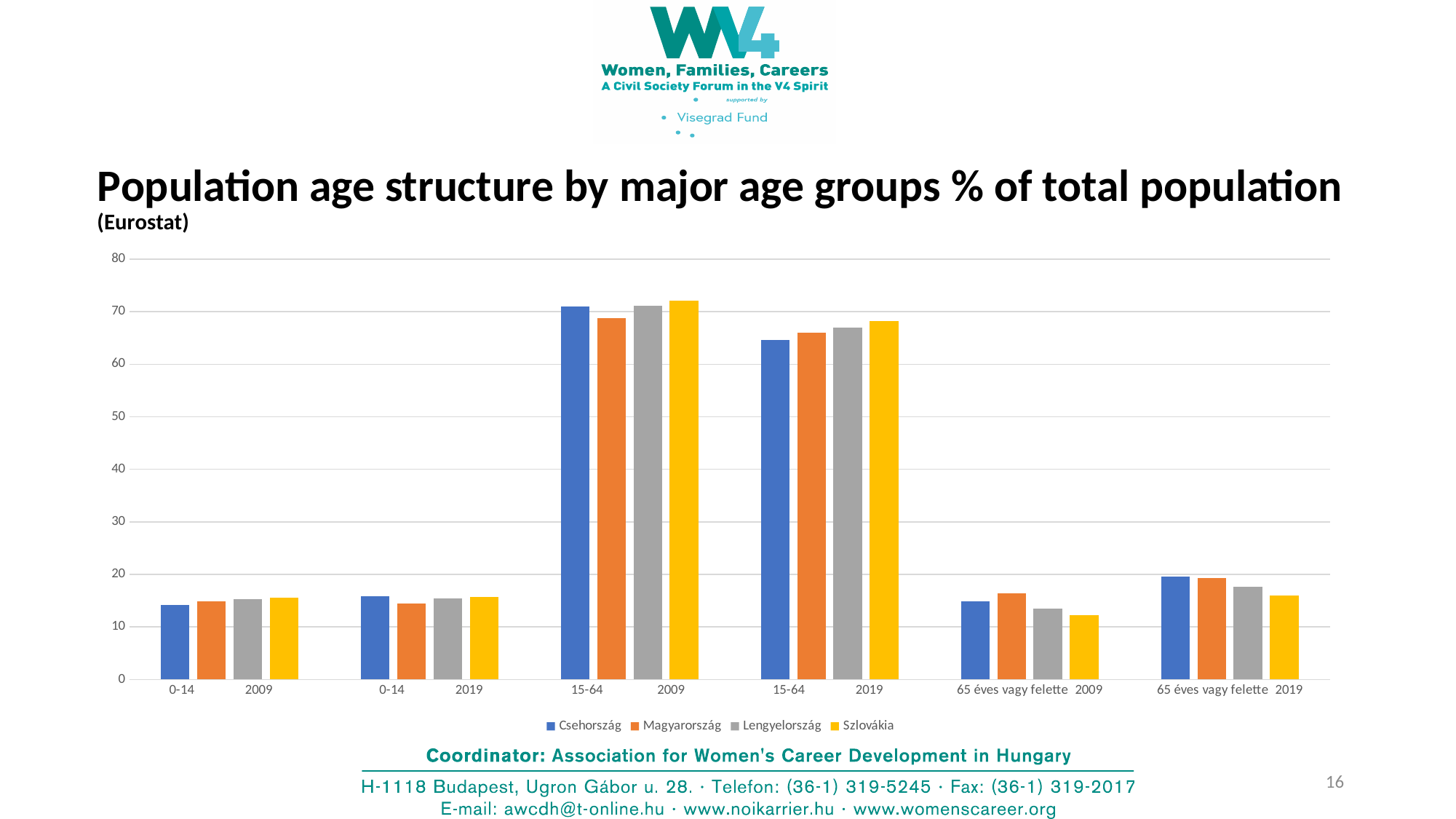
Is the value for Csehország in the 15-64 2019 group greater or less than 70? less In the 65 éves vagy felette 2009 group, which country has the lowest value? Szlovákia Is the value for Szlovákia in the 65 éves vagy felette 2009 group greater or less than 10? greater In the 15-64 2019 group, which country has the highest value? Szlovákia Does the value for Csehország in the 65 éves vagy felette group rise or fall from 2009 to 2019? rise Which colour represents Szlovákia in the legend? yellow Is the value for Szlovákia in the 15-64 2009 group greater or less than 70? greater In the 65 éves vagy felette 2009 group, which is larger: Magyarország or Szlovákia? Magyarország How many category groups are shown along the x axis? 6 How many series does the legend list? 4 What kind of chart is shown on the slide? bar chart